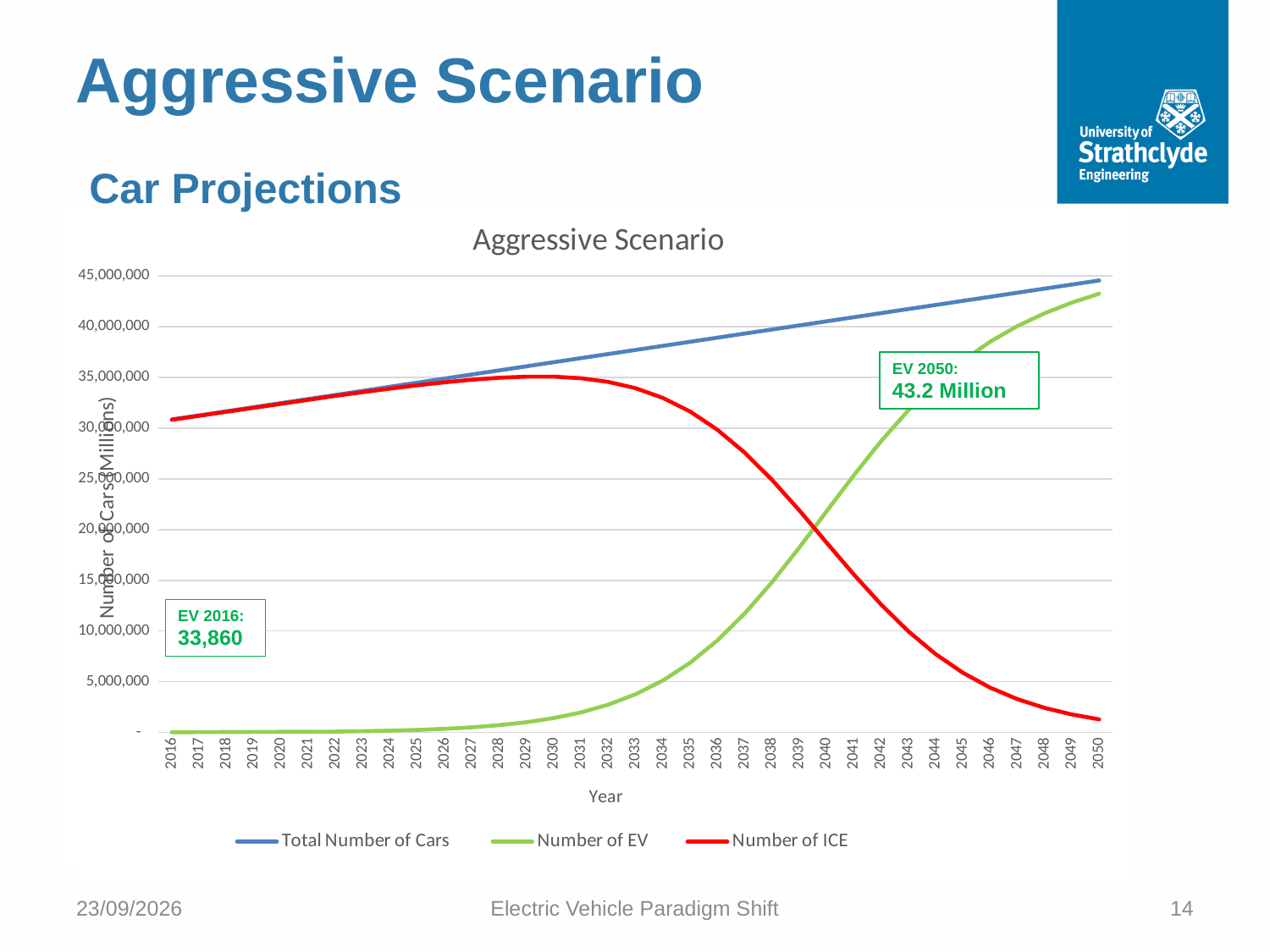
What is the label of the x axis? Year Which is larger in 2050, the Number of EV or the Number of ICE? Number of EV What kind of chart is shown on the slide? line chart What is the Number of EV in 2016 according to the annotation? 33,860 Which series has the highest value in 2050? Total Number of Cars What is the Number of EV in 2050 according to the annotation? 43.2 Million Does the Number of EV rise or fall from 2016 to 2050? rise How many series does the legend list? 3 Does the Total Number of Cars rise or fall from 2016 to 2050? rise Is the Number of ICE in 2030 greater or less than 30,000,000? greater How many years are plotted along the x axis? 35 Is the Number of ICE in 2050 greater or less than 5,000,000? less